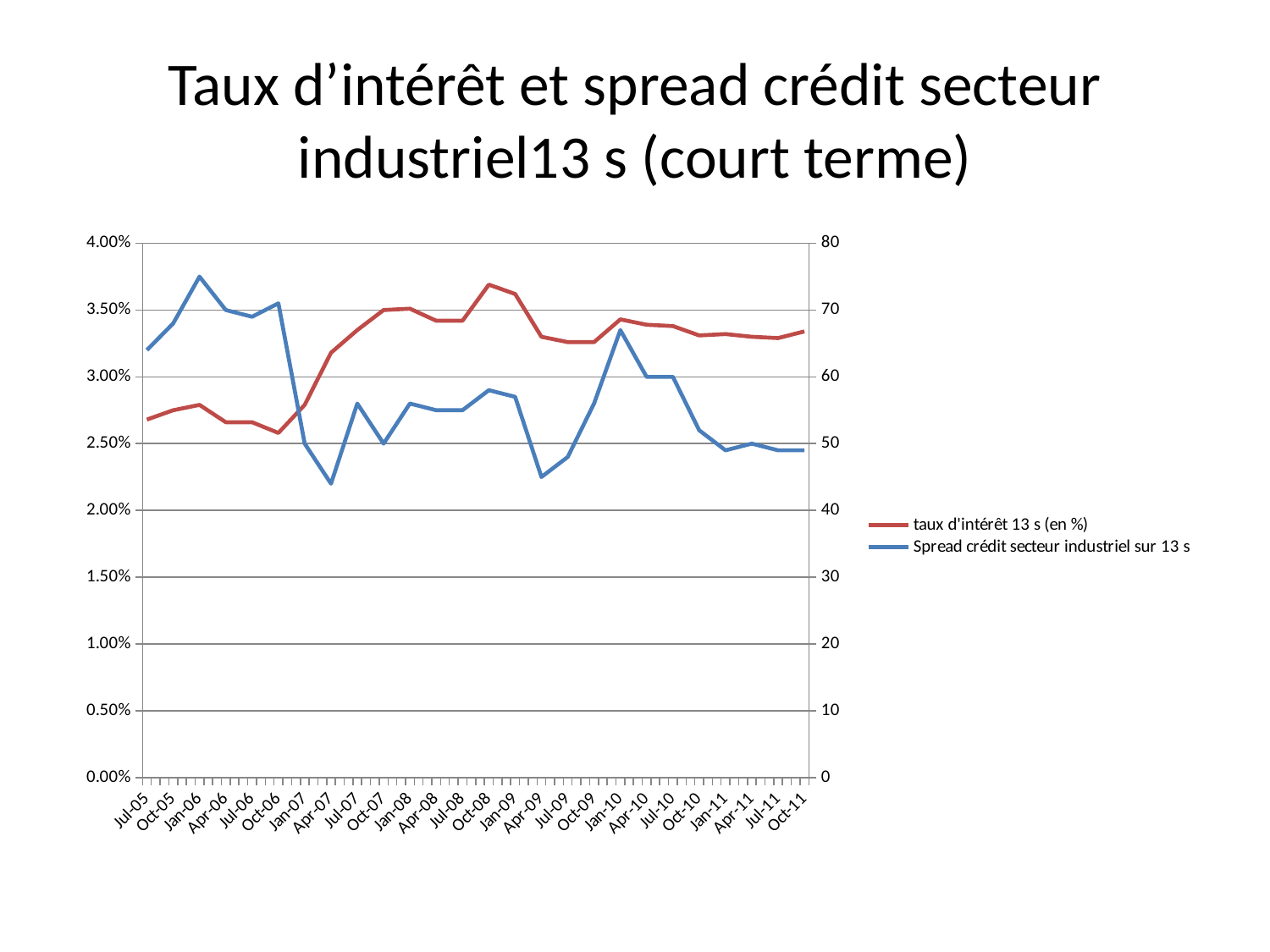
At which date does the Spread crédit secteur industriel sur 13 s series reach its highest value? Jan-06 Is the value of taux d'intérêt 13 s (en %) at Oct-08 greater or less than 3.50%? greater Which is larger for taux d'intérêt 13 s (en %): the value at Jan-08 or the value at Jul-05? Jan-08 Does the Spread crédit secteur industriel sur 13 s series rise or fall overall from Jan-10 to Oct-11? fall Is the value of taux d'intérêt 13 s (en %) at Oct-06 greater or less than 3.00%? less Is the value of Spread crédit secteur industriel sur 13 s at Jan-06 greater or less than 70? greater What kind of chart is shown on the slide? line chart At which date does the taux d'intérêt 13 s (en %) series reach its highest value? Oct-08 At which date does the taux d'intérêt 13 s (en %) series reach its lowest value? Oct-06 How many series does the legend list? 2